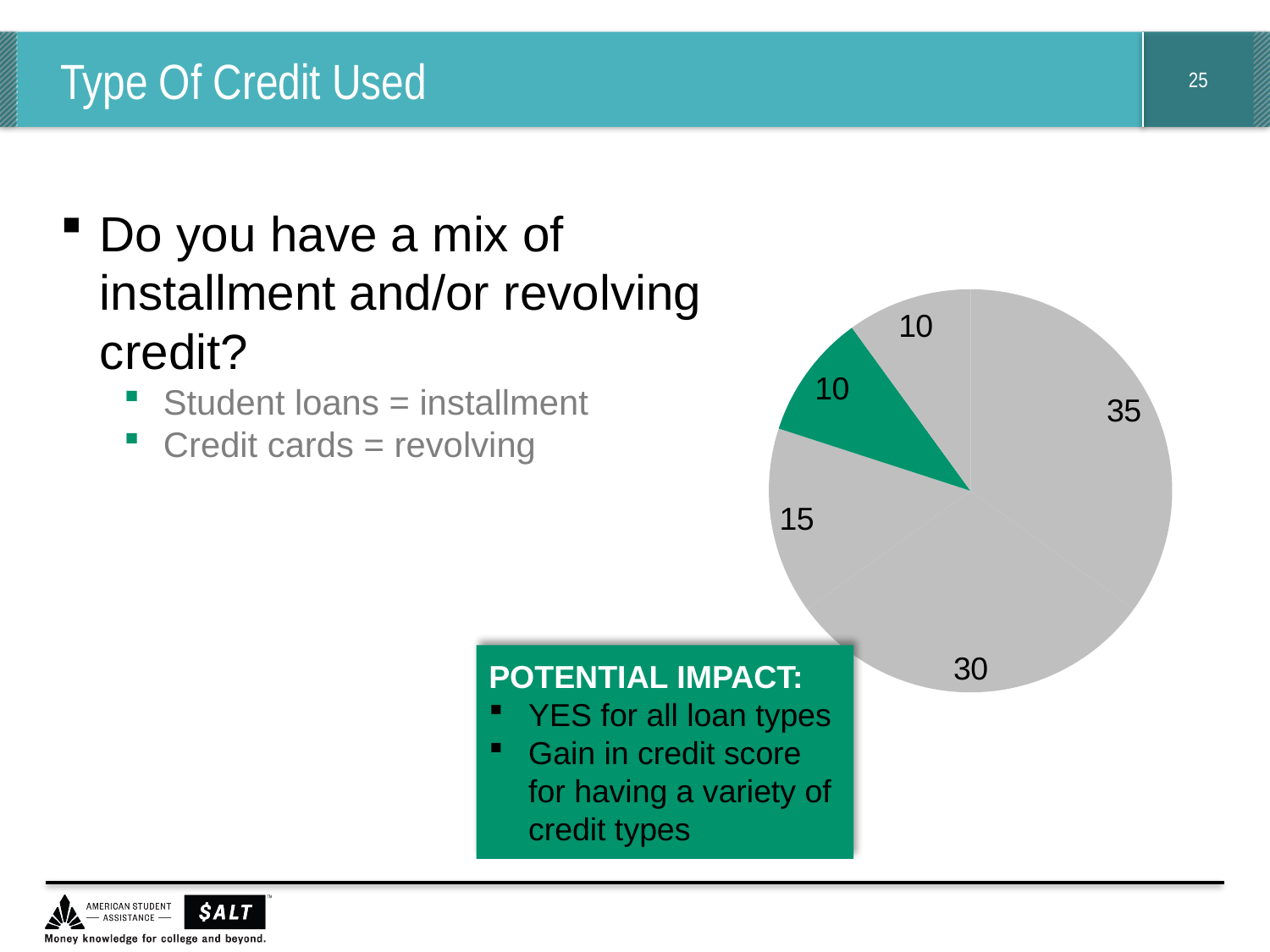
Which is larger, the slice labeled 30 or the slice labeled 15? 30 What is the smallest value labeled on the pie chart? 10 What share of the whole pie does the slice labeled 35 represent? 35% What is the difference between the largest slice (35) and the second largest slice (30)? 5 What colour are the non-highlighted slices of the pie chart? grey What is the value of the green (highlighted) slice of the pie chart? 10 How many slices does the pie chart have? 5 What is the largest value labeled on the pie chart? 35 Does the pie chart include a legend? No What is the sum of all the values labeled on the pie chart? 100 What kind of chart is shown on the slide? pie chart How many slices of the pie chart are labeled 10? 2